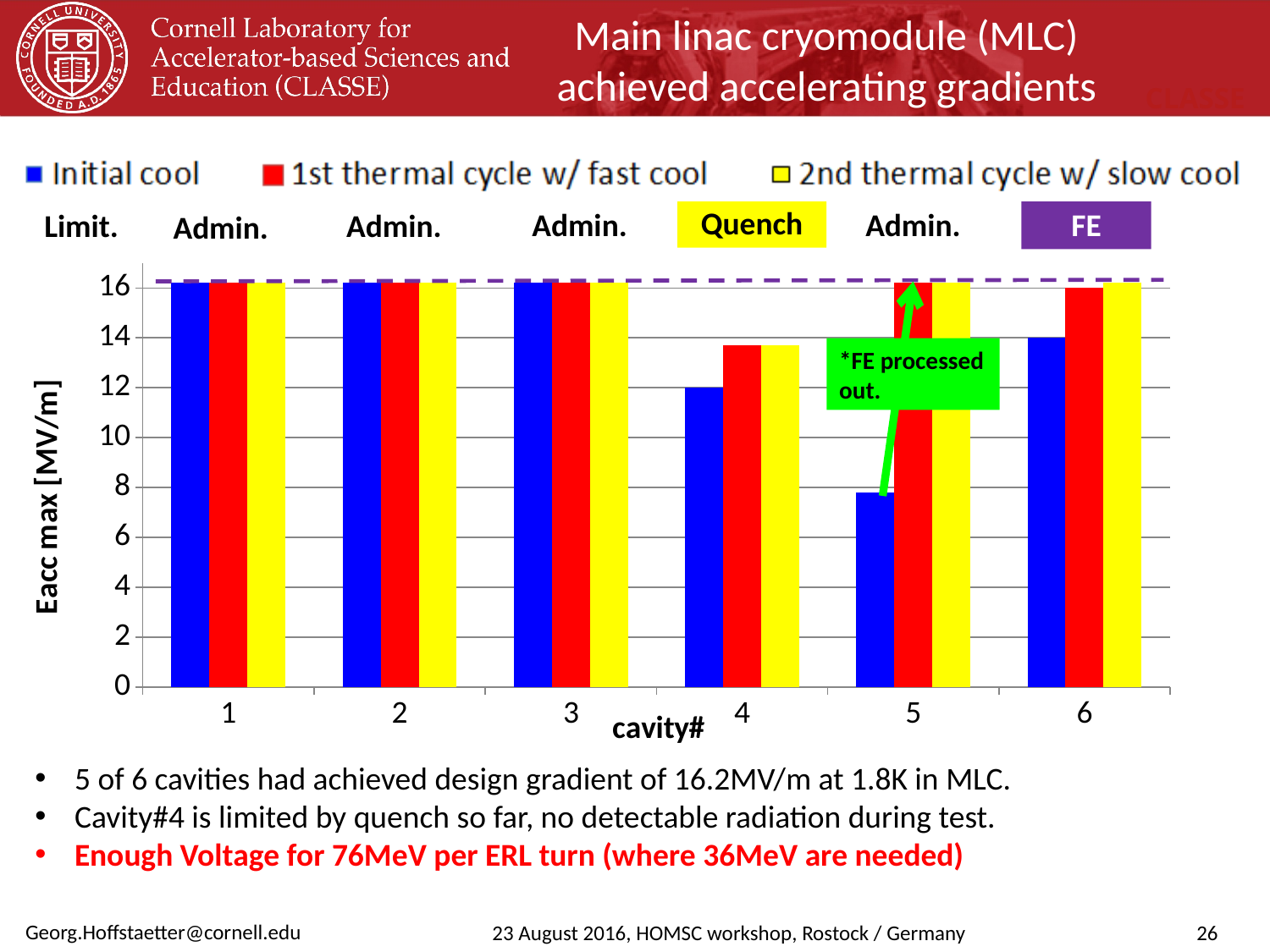
Which cavity has the lowest Initial cool value? 5 Is the Initial cool value for cavity 5 greater or less than 8? less What is the label of the y axis? Eacc max [MV/m] Which cavity has the lowest 2nd thermal cycle w/ slow cool value? 4 For cavity 6, which is larger: the Initial cool value or the 2nd thermal cycle w/ slow cool value? 2nd thermal cycle w/ slow cool What kind of chart is shown on the slide? bar chart Is the Initial cool value for cavity 4 greater or less than 14? less Is the 1st thermal cycle w/ fast cool value for cavity 5 greater or less than 14? greater Which series is shown in red in the legend? 1st thermal cycle w/ fast cool How many series does the legend list? 3 How many cavities are shown along the x axis? 6